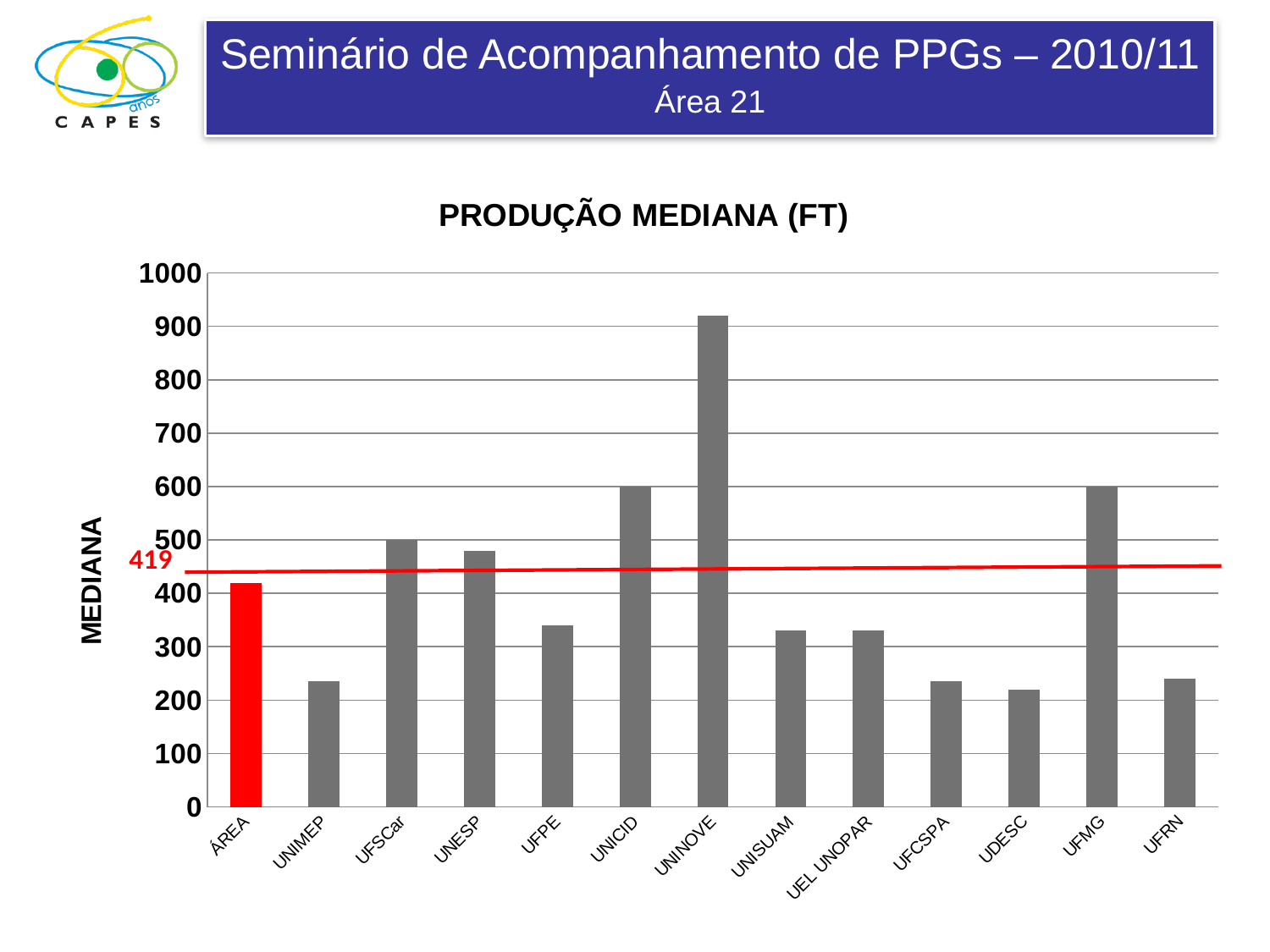
Is the value for UNINOVE greater or less than 900? greater Which is larger, the value for UNICID or the value for UFPE? UNICID What is the value for UFSCar? 500 What kind of chart is shown on the slide? bar chart Is the value for UNIMEP greater or less than 300? less Which category has the highest value in the chart? UNINOVE What is the value for UFMG? 600 Is the value for UFPE greater or less than 400? less What is the value for UNICID? 600 What is the title of the chart? PRODUÇÃO MEDIANA (FT) What value is labelled on the red horizontal line in the chart? 419 How many categories are shown on the x axis of the chart? 13